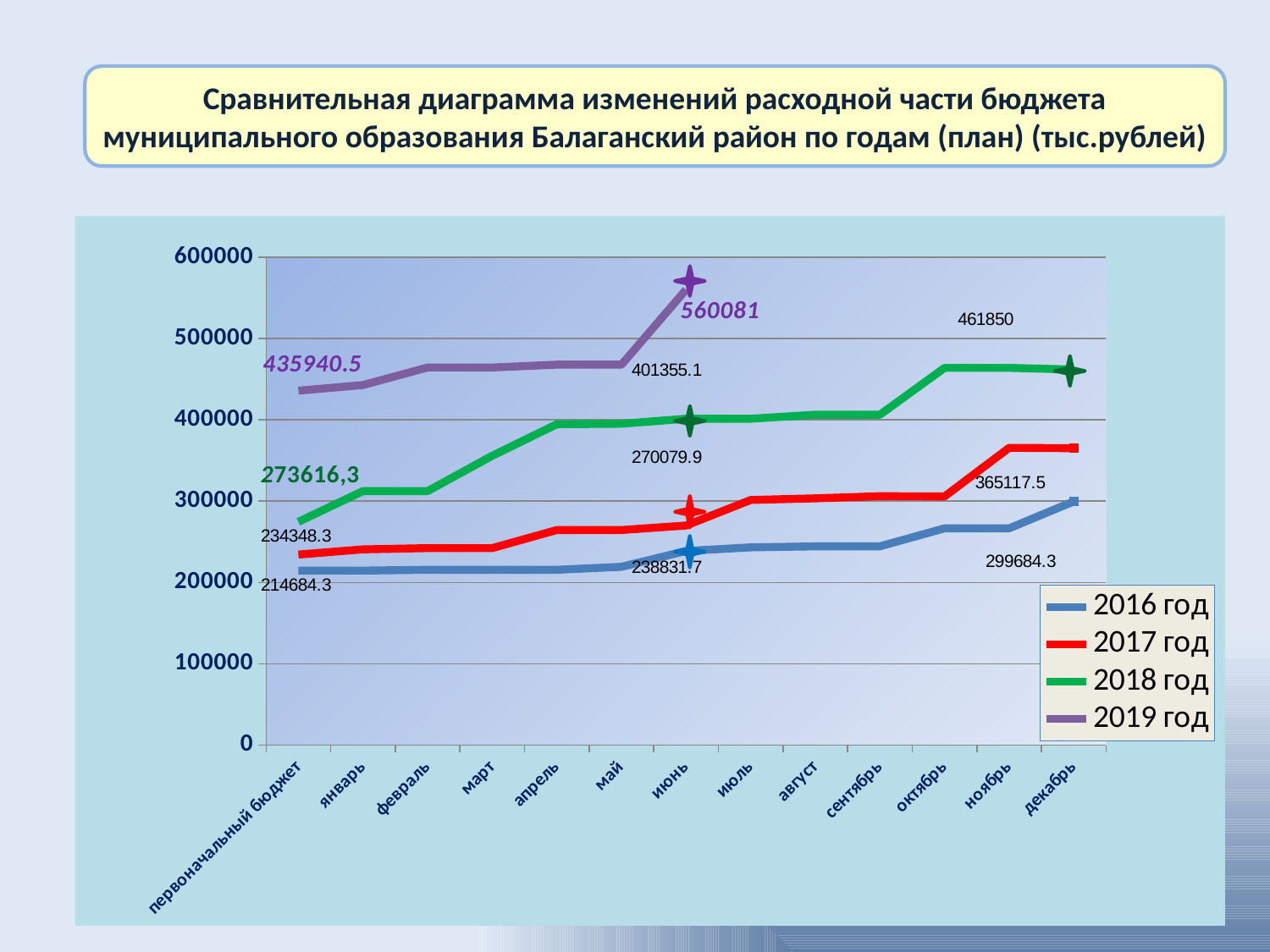
What is the value for 2019 год in июнь? 560081 How many categories are on the x axis? 13 How many series does the legend list? 4 What is the difference between 2018 год and 2017 год in декабрь? 96732.5 What is the value for 2016 год at первоначальный бюджет? 214684.3 What kind of chart is shown on the slide? line chart Which is larger in декабрь: 2017 год or 2016 год? 2017 год What is the value for 2017 год in июнь? 270079.9 What is the value for 2018 год in декабрь? 461850 Is the value for 2019 год in май greater or less than 400000? greater Which series has the highest value in июнь? 2019 год Does the 2016 год line rise or fall from первоначальный бюджет to декабрь? rise